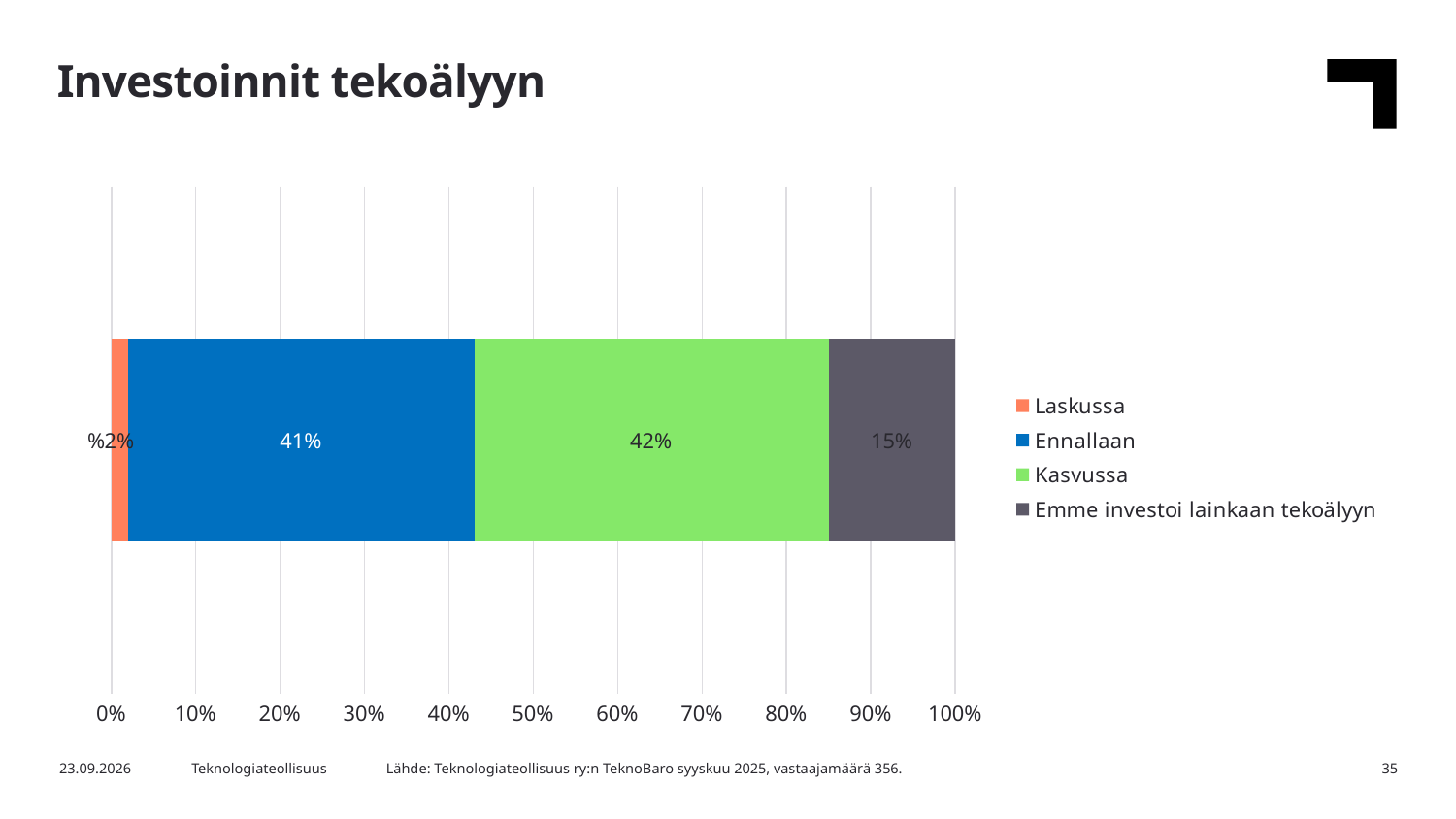
What kind of chart is shown on the slide? stacked bar chart Which series has the smallest share of the bar? Laskussa What is the value for Ennallaan? 41% What is the total of all segments in the stacked bar? 100% What is the value for Emme investoi lainkaan tekoälyyn? 15% How many series does the legend list? 4 What is the difference between the values for Kasvussa and Emme investoi lainkaan tekoälyyn? 27% What is the title of the chart? Investoinnit tekoälyyn What is the value for Kasvussa? 42% What is the difference between the values for Ennallaan and Laskussa? 39% What is the value for Laskussa? 2% Which is larger, the value for Kasvussa or the value for Emme investoi lainkaan tekoälyyn? Kasvussa